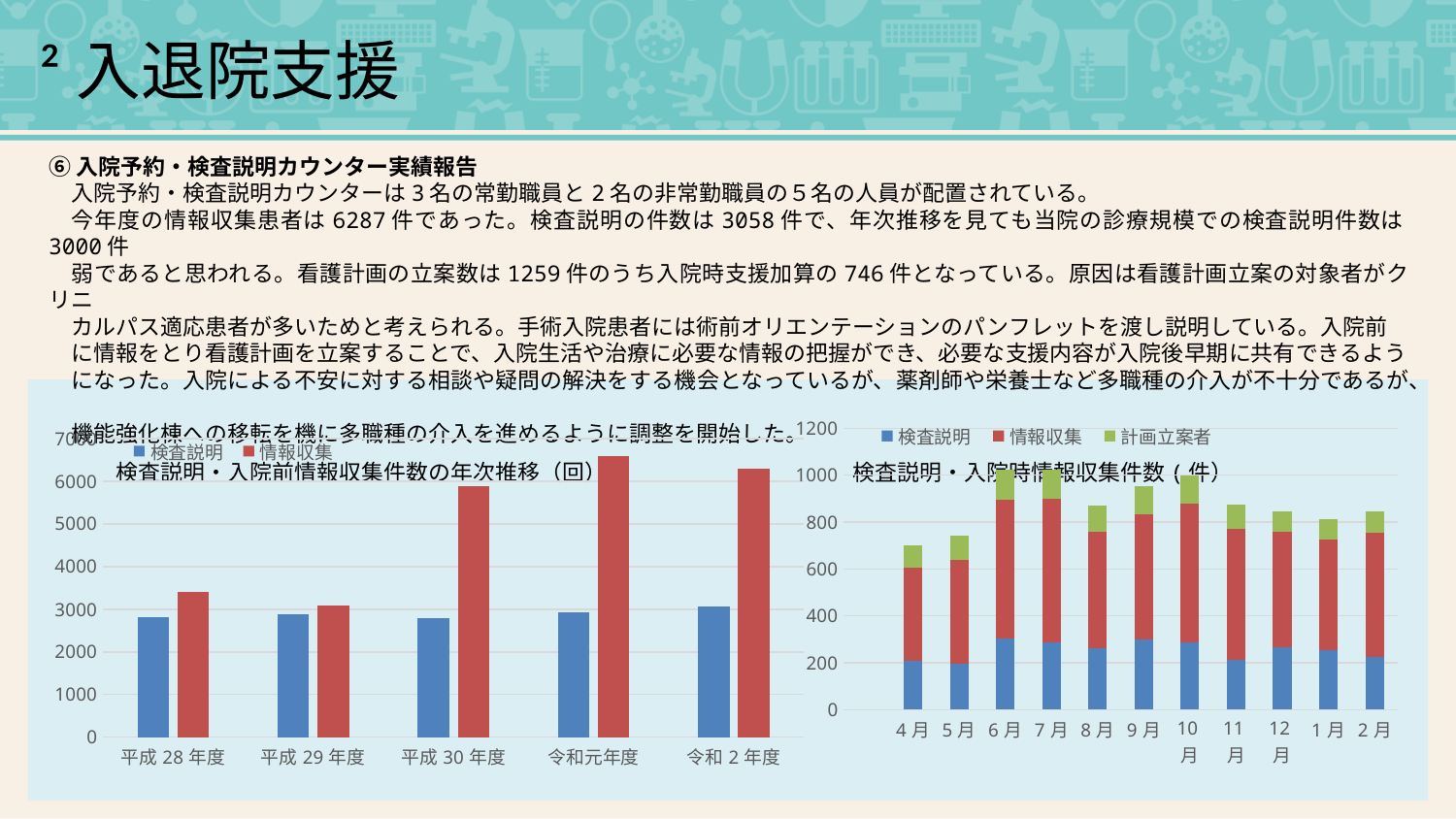
What kind of chart is the left chart titled 検査説明・入院前情報収集件数の年次推移（回）? bar chart In the left chart (検査説明・入院前情報収集件数の年次推移), which is larger for 令和2年度: 検査説明 or 情報収集? 情報収集 In the left chart (検査説明・入院前情報収集件数の年次推移), which fiscal year has the highest 情報収集 value? 令和元年度 How many months are shown on the x axis of the right chart (検査説明・入院時情報収集件数（件）)? 11 How many series does the legend of the right chart (検査説明・入院時情報収集件数（件）) list? 3 In the right chart (検査説明・入院時情報収集件数（件）), is the total stacked value for 4月 greater or less than 800? less In the left chart (検査説明・入院前情報収集件数の年次推移), is the 検査説明 value for 平成28年度 greater or less than 3000? less In the left chart (検査説明・入院前情報収集件数の年次推移), is the 情報収集 value for 平成30年度 greater or less than 5000? greater How many fiscal-year categories are shown on the x axis of the left chart (検査説明・入院前情報収集件数の年次推移)? 5 In the left chart (検査説明・入院前情報収集件数の年次推移), which fiscal year has the lowest 情報収集 value? 平成29年度 How many series does the legend of the left chart (検査説明・入院前情報収集件数の年次推移) list? 2 In the right chart (検査説明・入院時情報収集件数（件）), which month has the larger total stacked bar: 4月 or 6月? 6月